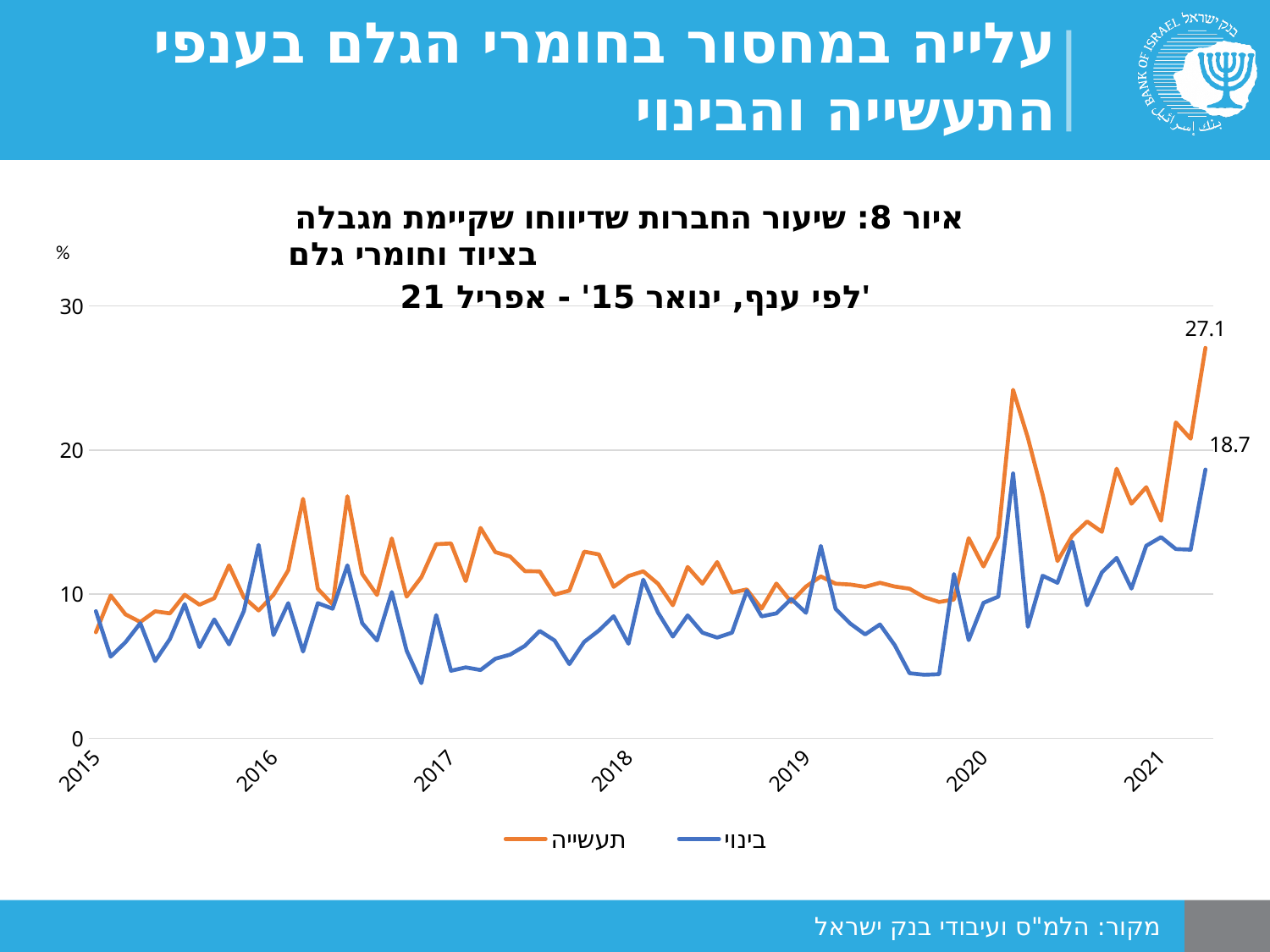
At the end of the period, which series has the higher value, תעשייה or בינוי? תעשייה Is the peak of the תעשייה series in early 2020 greater or less than 20? greater What unit is shown on the y axis of the chart? % What is the last labelled value for the בינוי series? 18.7 Is the final value for תעשייה greater or less than 20? greater What is the last labelled value for the תעשייה series? 27.1 What is the difference between the final labelled values of תעשייה (27.1) and בינוי (18.7)? 8.4 How many series does the legend list? 2 How many year labels are shown on the x axis? 7 What kind of chart is shown on the slide? line chart Do the values of both series rise or fall between 2020 and the end of the period in 2021? rise Is the final value for בינוי greater or less than 20? less